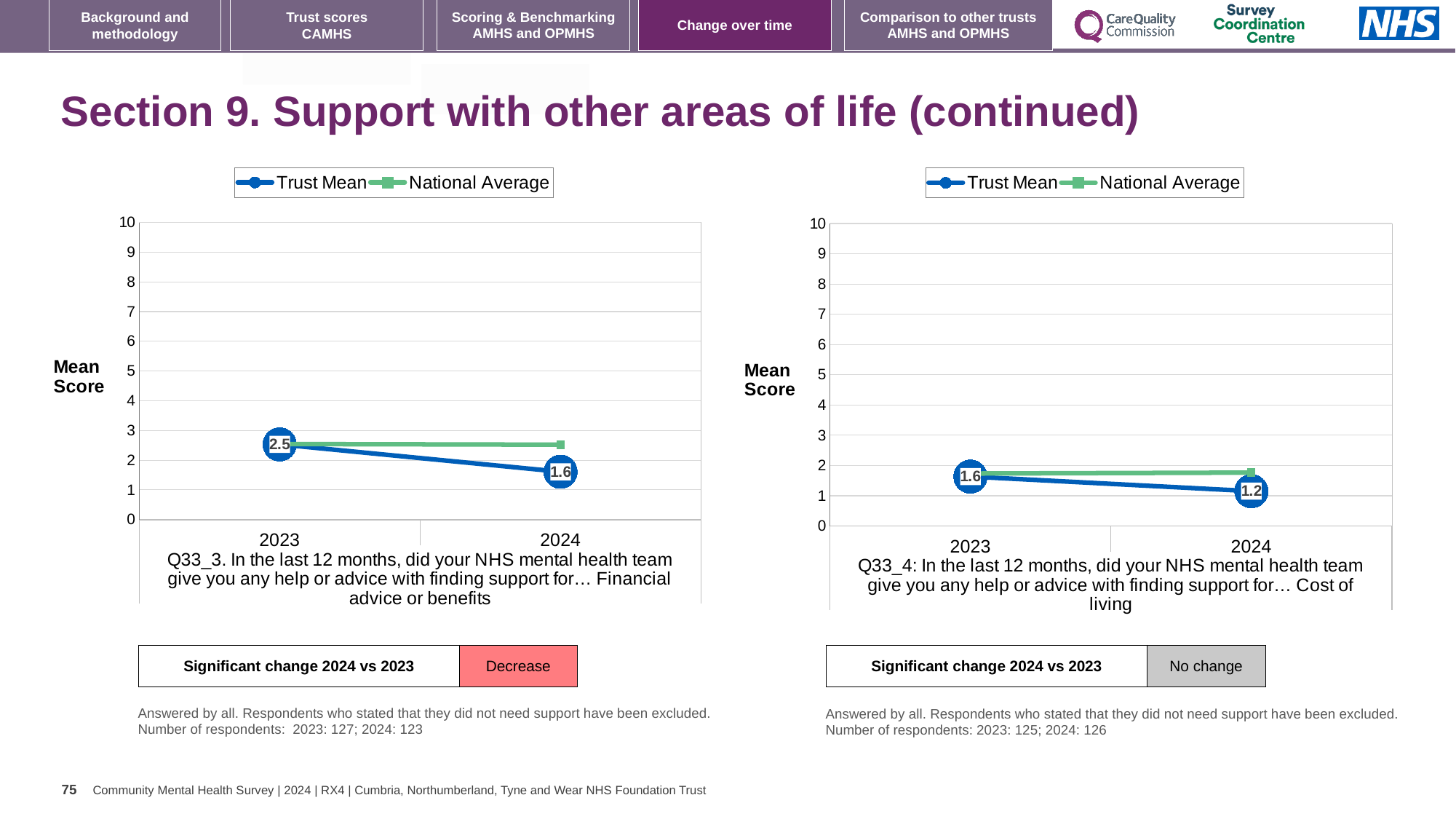
On the left chart (Q33_3), is the National Average for 2024 greater or less than 3? less On the left chart (Q33_3, Financial advice or benefits), what is the Trust Mean for 2023? 2.5 On the left chart (Q33_3, Financial advice or benefits), what is the Trust Mean for 2024? 1.6 What kind of chart is the right chart (Q33_4)? line chart How many series does the legend of the left chart list? 2 On the right chart (Q33_4, Cost of living), what is the Trust Mean for 2024? 1.2 On the right chart (Q33_4), what is the difference between the Trust Mean in 2023 and 2024? 0.4 On the left chart (Q33_3), does the Trust Mean rise or fall from 2023 to 2024? fall On the left chart (Q33_3), which is larger in 2024: the Trust Mean or the National Average? National Average How many years are plotted on the x axis of the right chart (Q33_4)? 2 On the left chart (Q33_3), by how much did the Trust Mean change from 2023 to 2024? 0.9 On the right chart (Q33_4, Cost of living), what is the Trust Mean for 2023? 1.6